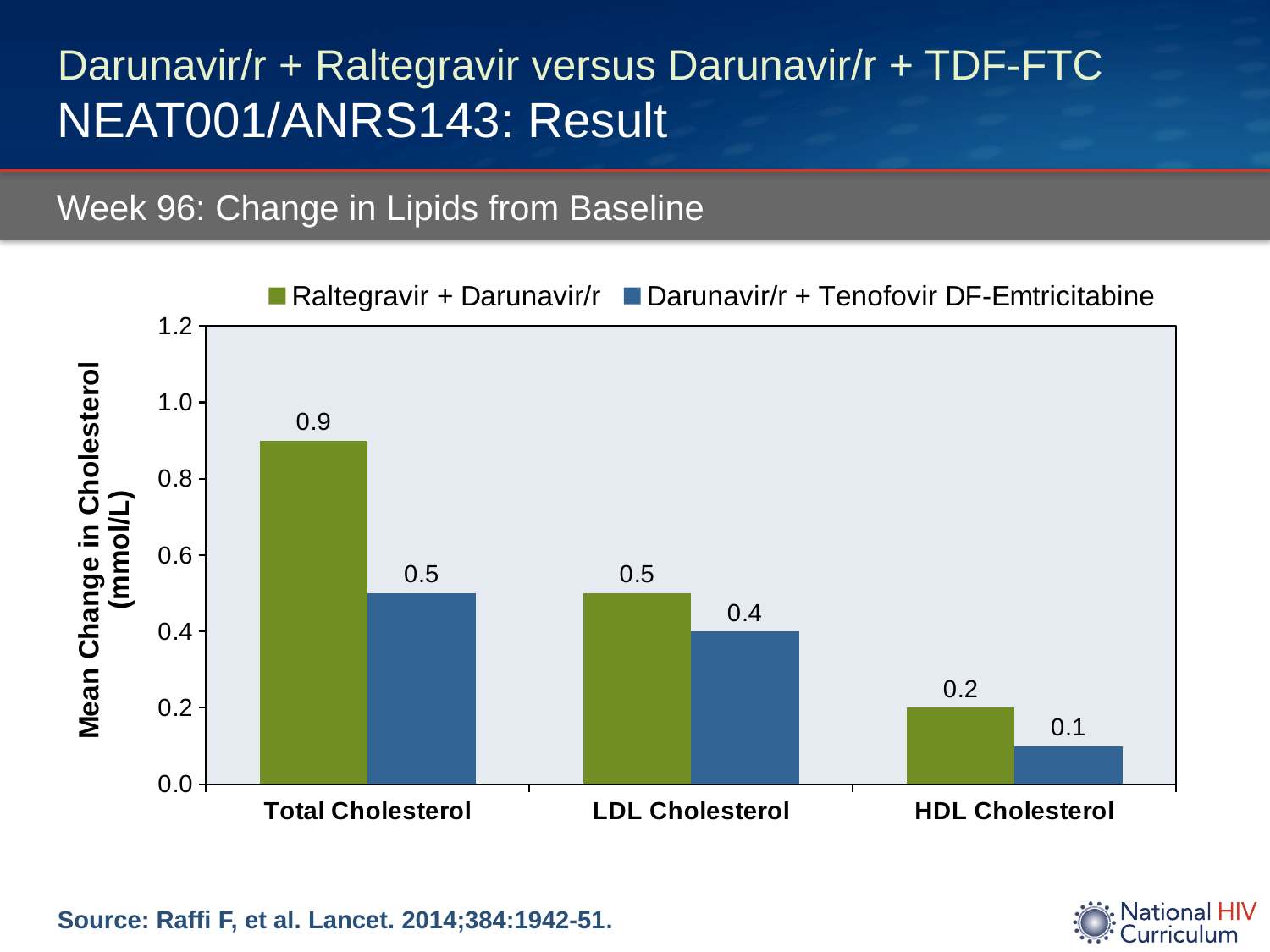
What is the mean change in LDL Cholesterol for Darunavir/r + Tenofovir DF-Emtricitabine? 0.4 For LDL Cholesterol, which series has the larger value? Raltegravir + Darunavir/r What is the y-axis label of the chart? Mean Change in Cholesterol (mmol/L) What is the mean change in HDL Cholesterol for Raltegravir + Darunavir/r? 0.2 How many series does the legend list? 2 Which category has the lowest value for Darunavir/r + Tenofovir DF-Emtricitabine? HDL Cholesterol How many categories are shown on the x axis? 3 Which category has the highest value for Raltegravir + Darunavir/r? Total Cholesterol What is the difference between the two series for Total Cholesterol? 0.4 Is the value for Total Cholesterol in the Darunavir/r + Tenofovir DF-Emtricitabine series greater or less than 0.6? less What is the mean change in Total Cholesterol for Raltegravir + Darunavir/r? 0.9 What kind of chart is shown on the slide? Bar chart